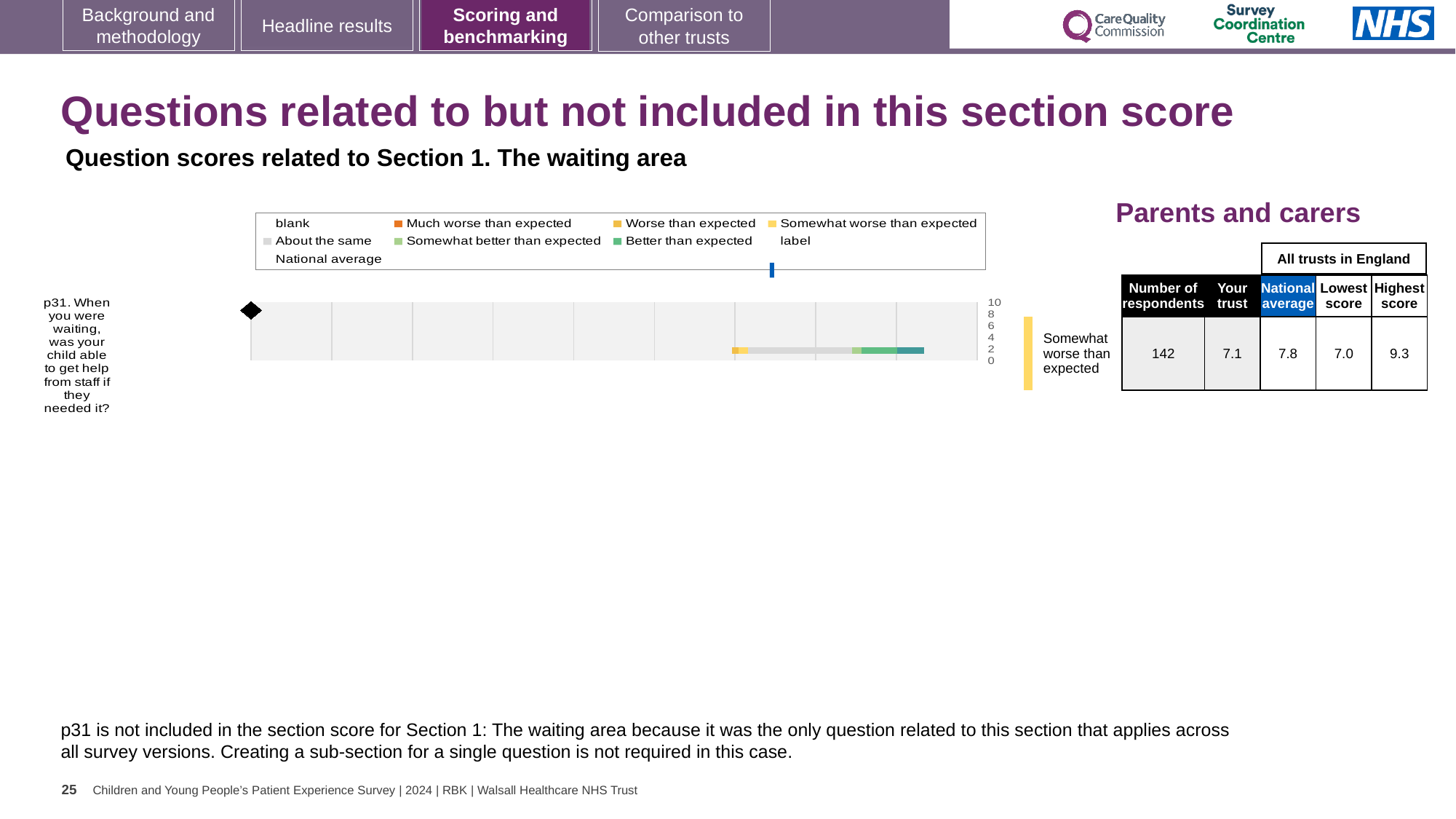
How many questions are plotted in the chart? 1 How many entries does the chart legend list? 9 According to the table beside the chart, what is the national average score for p31? 7.8 According to the table beside the chart, what is the highest score among all trusts in England for p31? 9.3 What kind of chart is used to show the p31 question score? bar chart What rating category is shown beside the bar for p31? Somewhat worse than expected According to the table beside the chart, what is the lowest score among all trusts in England for p31? 7.0 According to the table beside the chart, what is the 'Your trust' score for p31? 7.1 According to the table beside the chart, how many respondents answered p31? 142 For p31, which is larger: the 'Your trust' score or the national average? National average Which question is plotted in the chart? p31. When you were waiting, was your child able to get help from staff if they needed it? By how much does the national average for p31 exceed the 'Your trust' score? 0.7